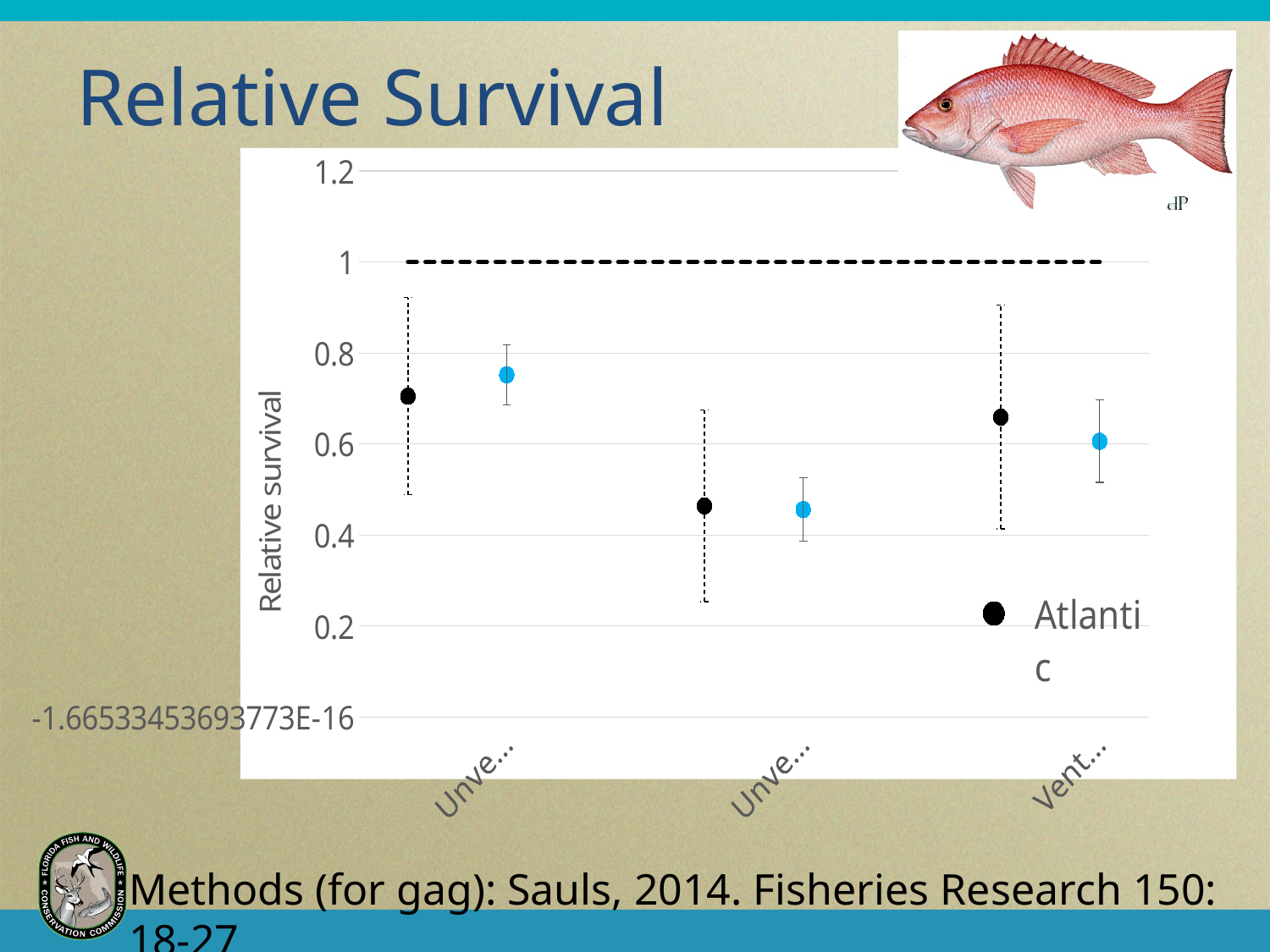
Which of the three black (Atlantic) points has the lowest value: leftmost, middle or rightmost? middle Is the value of the middle black (Atlantic) point greater or less than 0.6? less What kind of chart is shown on the slide? scatter chart Which series name is readable in the chart's legend? Atlantic Is the value of the middle blue point greater or less than 0.6? less What is the label on the vertical axis of the chart? Relative survival At what y-axis value is the horizontal dashed line drawn? 1 Is the value of the leftmost black (Atlantic) point greater or less than 0.6? greater How many groups of points are plotted along the x axis? 3 Which is larger: the leftmost black (Atlantic) point or the middle black (Atlantic) point? the leftmost black point